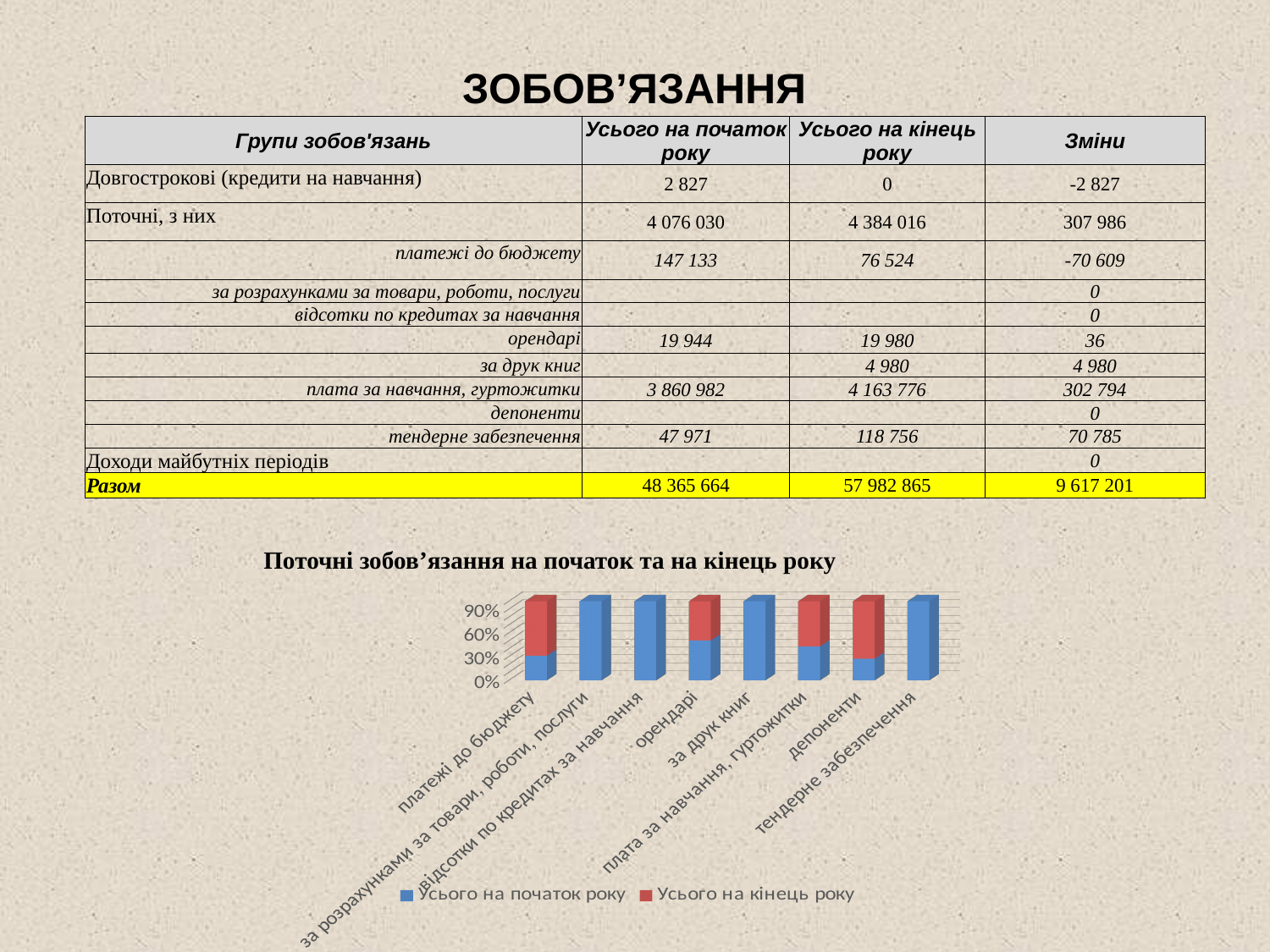
In the chart, which series has the larger share in the "платежі до бюджету" bar: "Усього на початок року" or "Усього на кінець року"? Усього на кінець року What kind of chart is shown on the slide? stacked bar chart In the chart, is the share for "Усього на початок року" in the "депоненти" bar greater or less than 90%? less How many categories are shown along the x axis of the chart? 8 Which colour represents the series "Усього на кінець року" in the chart? red In the chart, is the share for "Усього на початок року" in the "платежі до бюджету" bar greater or less than 60%? less In the chart, is the share for "Усього на початок року" in the "тендерне забезпечення" bar greater or less than 60%? greater How many series does the chart legend list? 2 What is the title of the chart on the slide? Поточні зобов’язання на початок та на кінець року In the chart, which series has the larger share in the "тендерне забезпечення" bar: "Усього на початок року" or "Усього на кінець року"? Усього на початок року